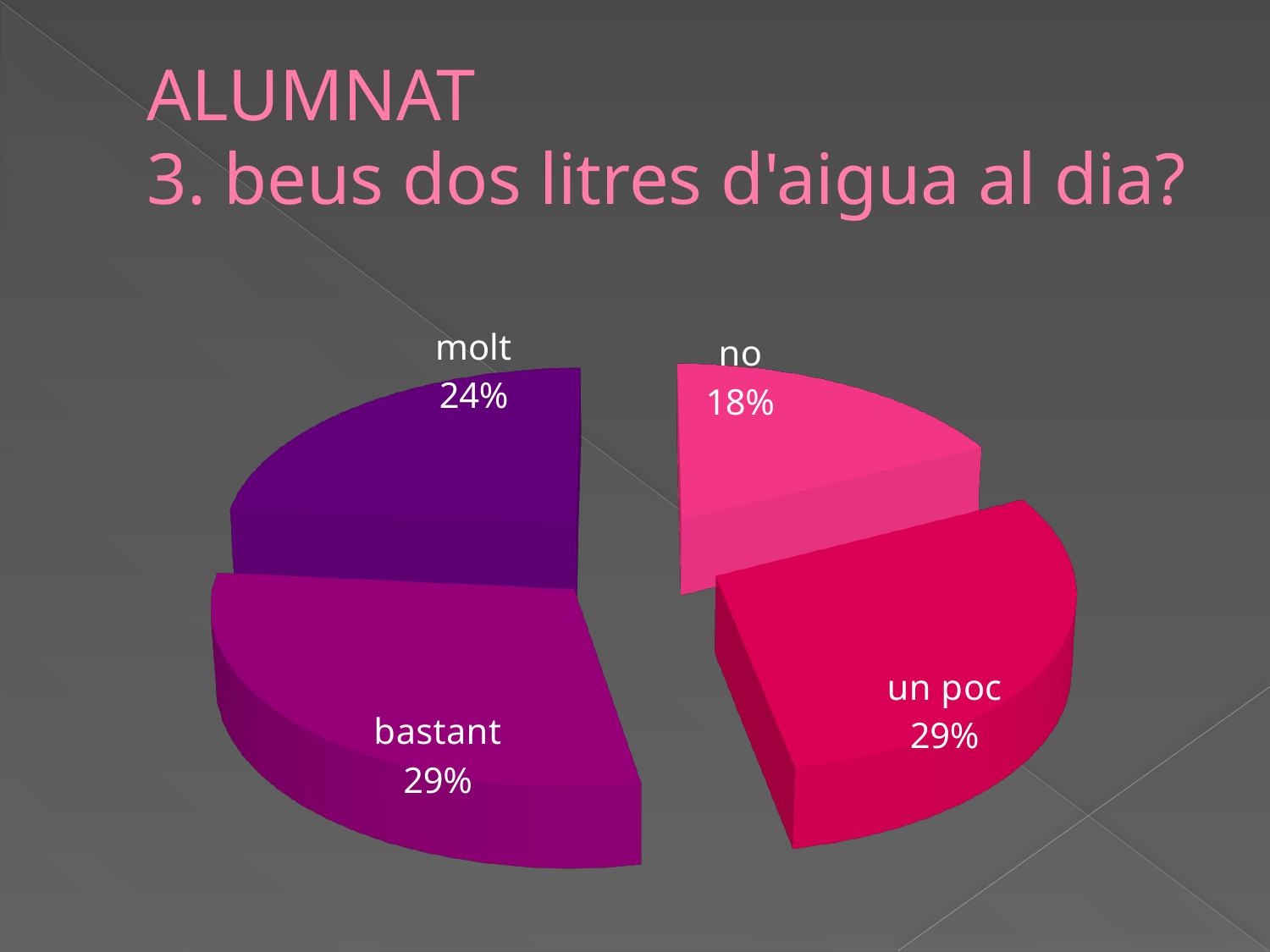
What kind of chart is shown on the slide? pie chart What percentage of the pie is the 'bastant' slice? 29% What is the question shown in the slide title above the chart? 3. beus dos litres d'aigua al dia? What is the difference in percentage points between the 'bastant' slice and the 'no' slice? 11 Which is larger, the 'molt' slice or the 'no' slice? molt Which is larger, the 'un poc' slice or the 'molt' slice? un poc Which slice has the smallest share of the pie? no What percentage of the pie is the 'un poc' slice? 29% What is the difference in percentage points between the 'molt' slice and the 'no' slice? 6 What percentage of the pie is the 'molt' slice? 24% How many slices does the pie chart have? 4 What percentage of the pie is the 'no' slice? 18%